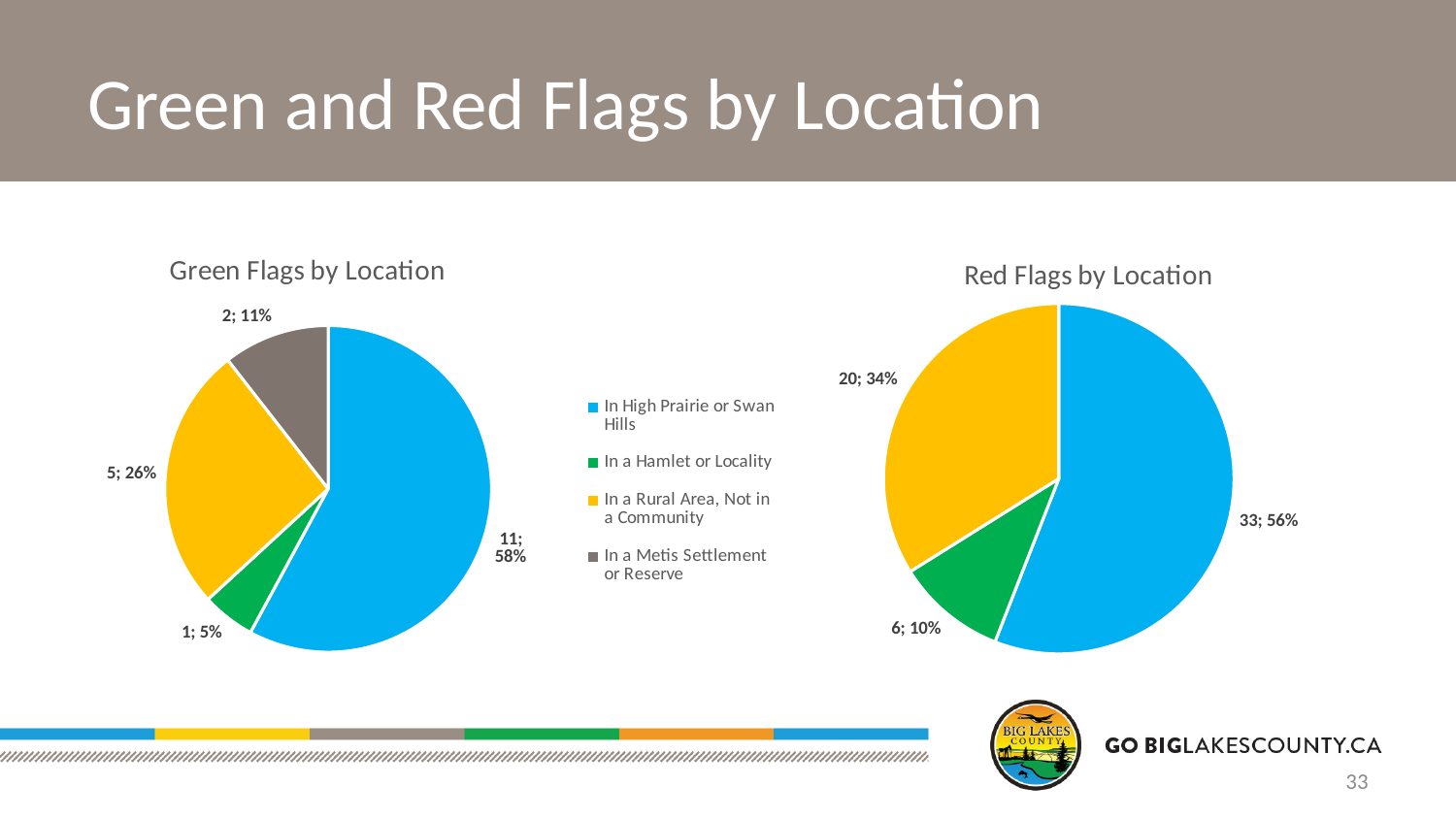
How many slices does the Red Flags by Location pie chart have? 3 How many entries does the legend between the two charts list? 4 In the Red Flags by Location chart, what is the value for In a Rural Area, Not in a Community? 20; 34% What kind of chart is Green Flags by Location? Pie chart In the Red Flags by Location chart, which location has the smallest slice? In a Hamlet or Locality In the Green Flags by Location chart, what is the value for In High Prairie or Swan Hills? 11; 58% In the Green Flags by Location chart, which location has the largest slice? In High Prairie or Swan Hills In the Red Flags by Location chart, what is the difference in count between In High Prairie or Swan Hills and In a Rural Area, Not in a Community? 13 In the Green Flags by Location chart, what share of the pie is In a Metis Settlement or Reserve? 11% In the Red Flags by Location chart, what share of the pie is In a Hamlet or Locality? 10% In the Green Flags by Location chart, which location has the smallest slice? In a Hamlet or Locality In the Green Flags by Location chart, which is larger: In a Rural Area, Not in a Community or In a Metis Settlement or Reserve? In a Rural Area, Not in a Community